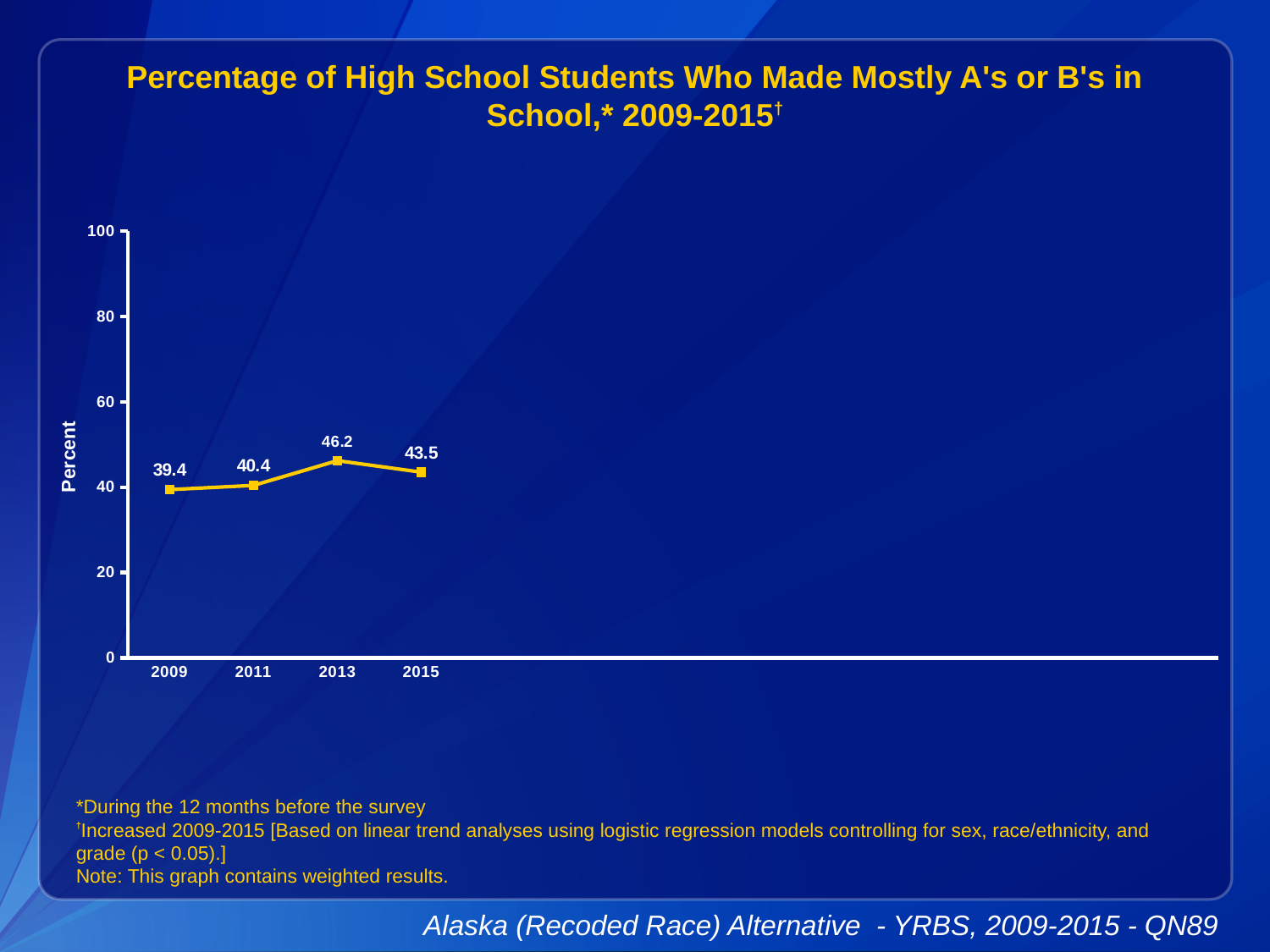
Does the value rise or fall from 2013 to 2015? fall What is the value for 2009? 39.4 Which is larger, the value for 2011 or the value for 2015? 2015 How many years are plotted on the chart? 4 What is the label on the y axis? Percent What is the difference between the values for 2013 and 2009? 6.8 What is the value for 2015? 43.5 Which year has the lowest value? 2009 Is the value for 2013 greater or less than 40? greater What is the value for 2013? 46.2 What kind of chart is shown? line chart Which year has the highest value? 2013